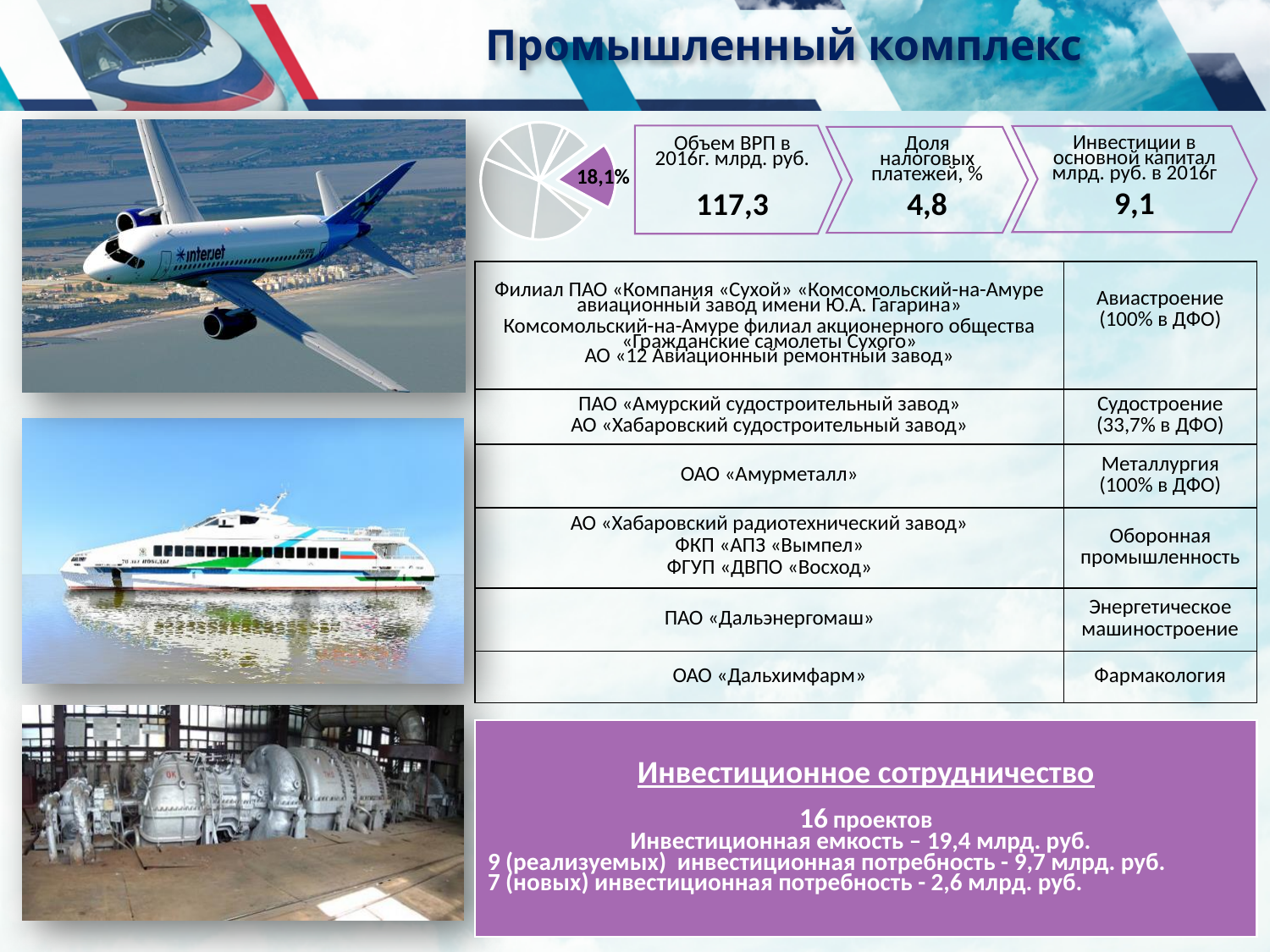
What share of the pie does the highlighted slice represent? 18,1% What kind of chart is shown at the top of the slide next to the indicator boxes? pie chart Is the highlighted slice of the pie chart larger or smaller than the remaining grey portion of the pie combined? smaller How many slices of the pie chart have a printed data label? 1 What colour is the slice of the pie chart that carries the data label? purple What value is printed on the highlighted (purple) slice of the pie chart? 18,1%